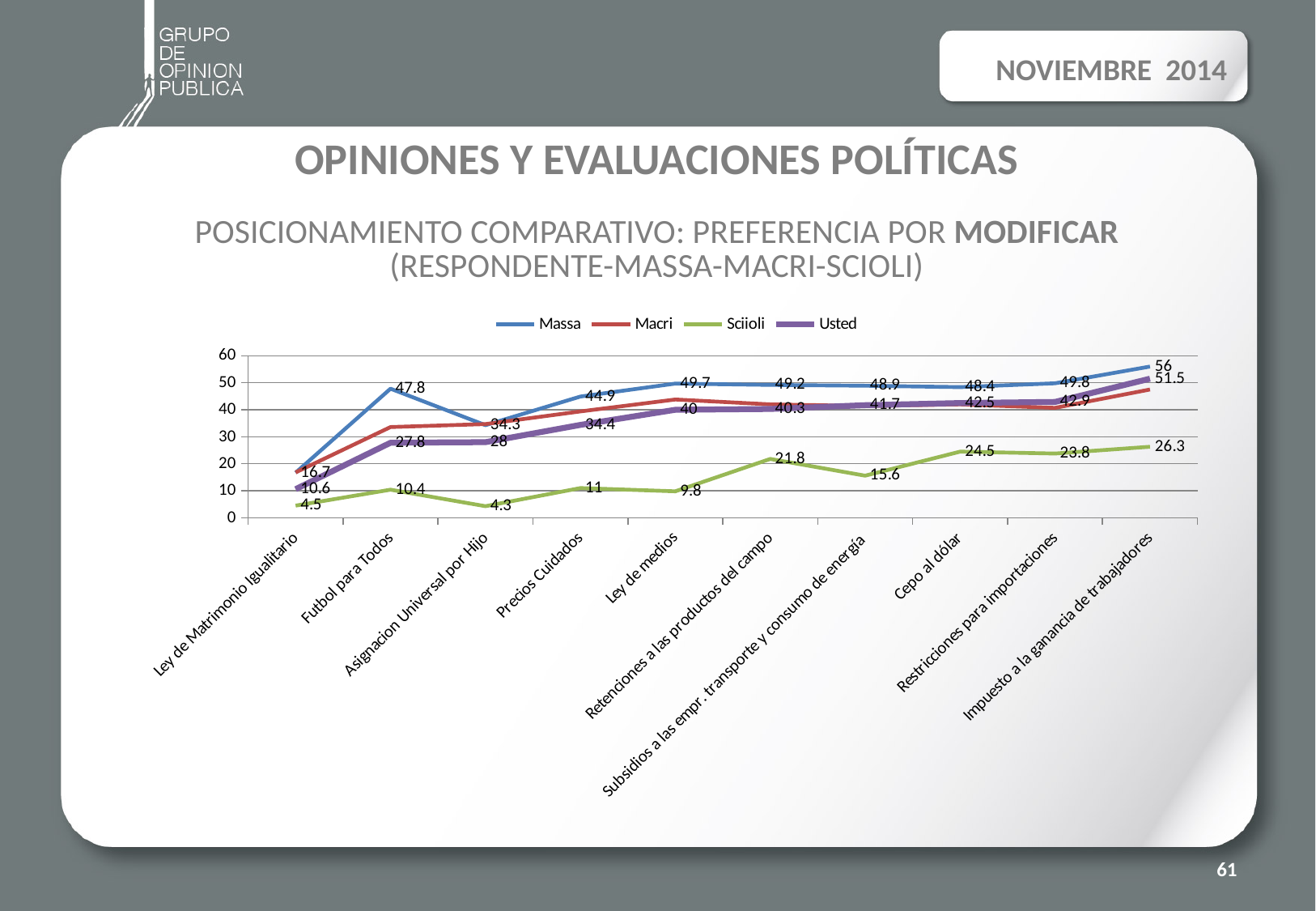
For which category is the Sciioli series highest? Impuesto a la ganancia de trabajadores How many series does the legend list? 4 What type of chart is shown on the slide? Line chart What is the value for Sciioli for Retenciones a las productos del campo? 21.8 How many categories are shown along the x axis? 10 Which series is shown in green in the legend? Sciioli What is the difference between the Massa and Usted values for Impuesto a la ganancia de trabajadores? 4.5 Is the value for Macri for Impuesto a la ganancia de trabajadores greater or less than 40? greater Which is larger for Futbol para Todos, the Massa value or the Sciioli value? Massa What is the value for Massa for Futbol para Todos? 47.8 For which category is the Sciioli series lowest? Asignacion Universal por Hijo What is the value for Usted for Impuesto a la ganancia de trabajadores? 51.5